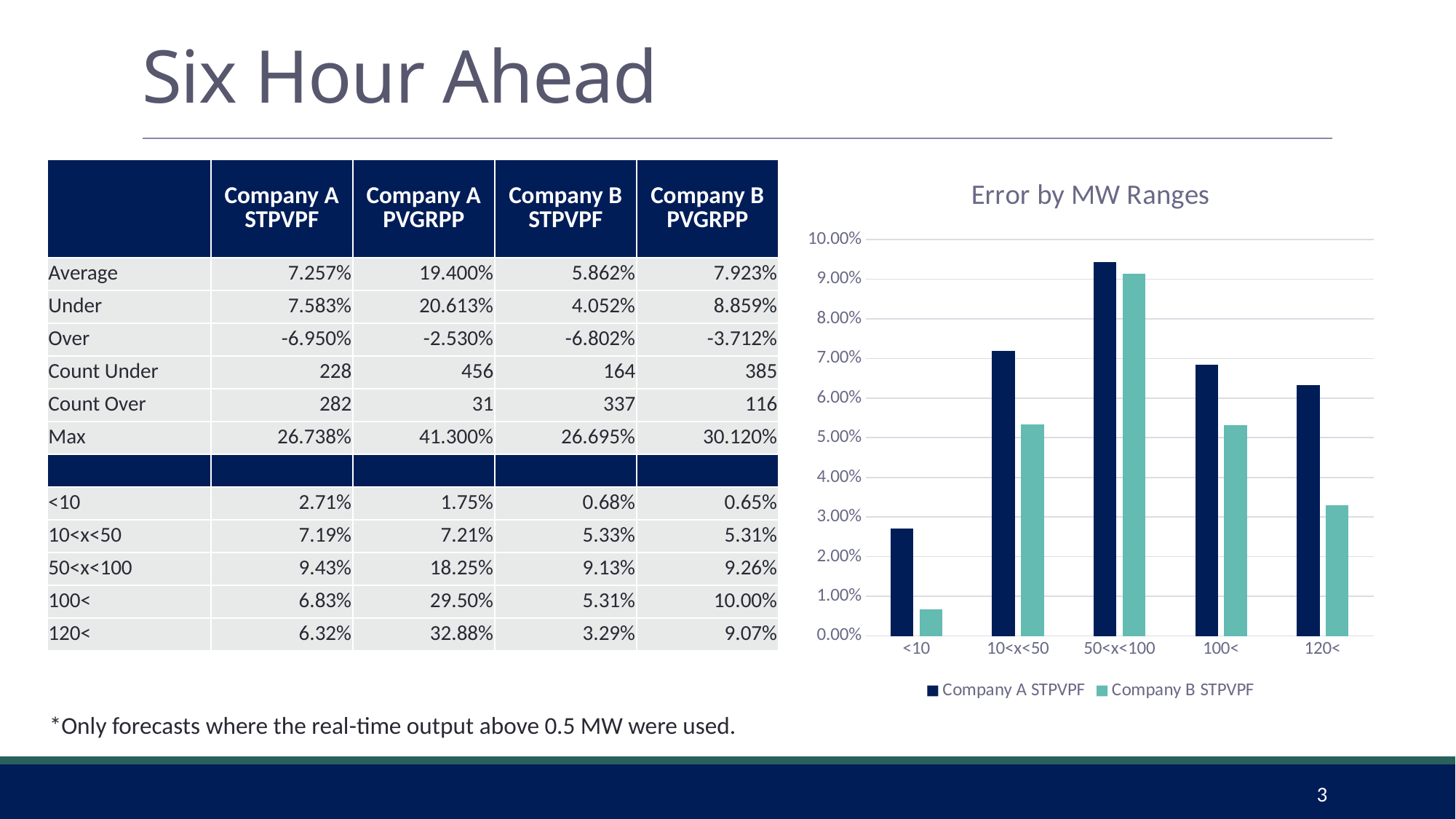
Which colour represents Company B STPVPF in the chart? teal (green) How many series does the chart legend list? 2 How many MW range categories are shown on the x axis of the chart? 5 In the chart, do the Company B STPVPF values rise or fall from the 50<x<100 range to the 120< range? fall Is the value for Company B STPVPF in the 120< range greater or less than 4.00%? less In the chart, which MW range has the highest value for Company A STPVPF? 50<x<100 What type of chart is shown on the slide? bar chart In the chart, for the 100< range, which series has the larger value, Company A STPVPF or Company B STPVPF? Company A STPVPF Is the value for Company B STPVPF in the <10 range greater or less than 1.00%? less In the chart, which MW range has the lowest value for Company B STPVPF? <10 What is the title of the chart? Error by MW Ranges Is the value for Company A STPVPF in the 10<x<50 range greater or less than 6.00%? greater